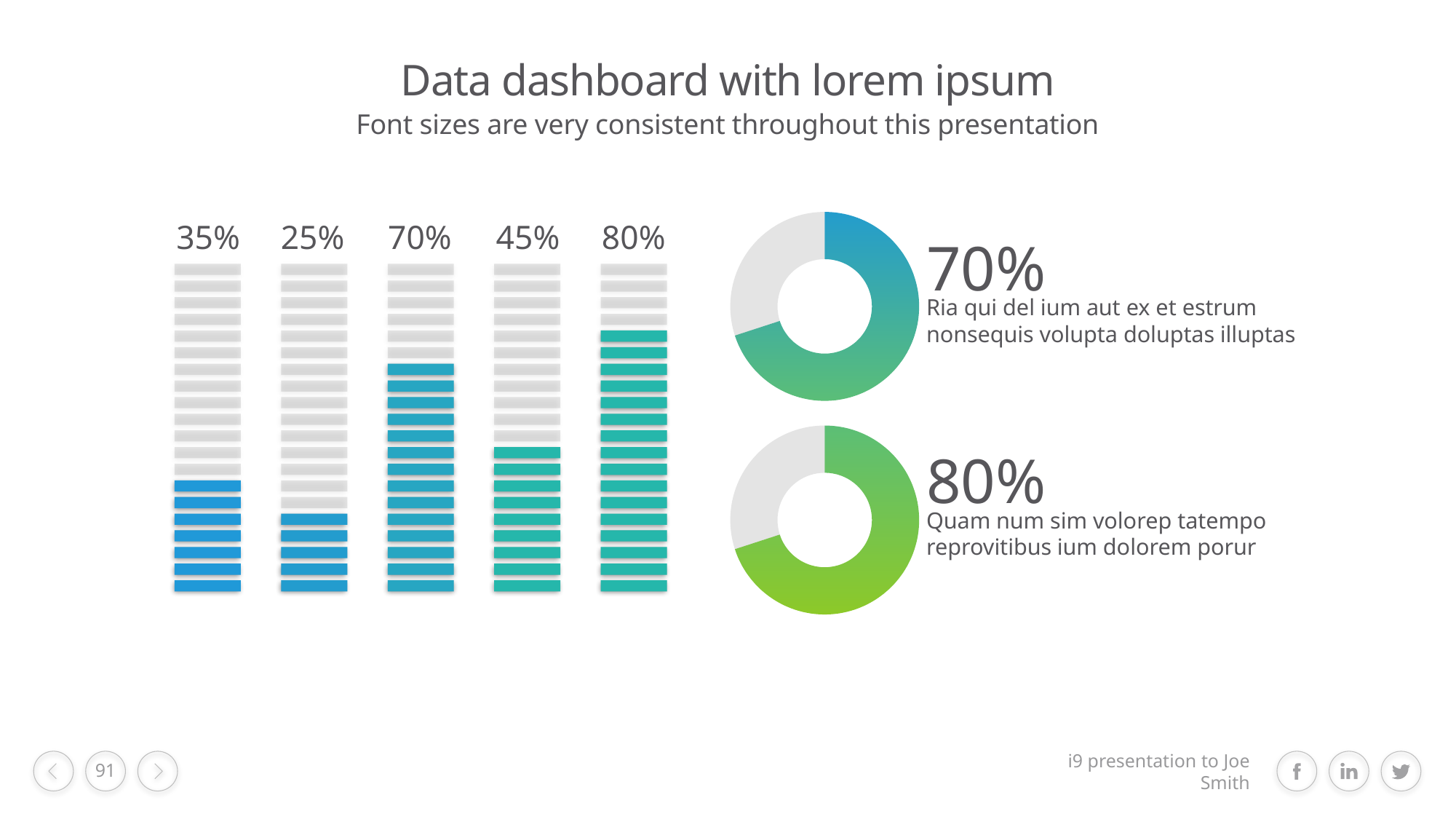
In the bar chart on the left, what value is shown above the third bar? 70% What percentage is shown next to the upper donut chart on the right? 70% In the bar chart on the left, which is larger: the first bar or the fourth bar? The fourth bar (45%) In the bar chart on the left, which bar has the lowest value? The second bar, 25% How many bars are in the bar chart on the left? 5 In the bar chart on the left, what is the difference between the third bar (70%) and the fourth bar (45%)? 25% In the bar chart on the left, what is the difference between the fifth bar (80%) and the second bar (25%)? 55% In the bar chart on the left, what value is shown above the first (leftmost) bar? 35% In the bar chart on the left, what value is shown above the fifth (rightmost) bar? 80% In the bar chart on the left, which bar has the highest value? The fifth (rightmost) bar, 80% What percentage is shown next to the lower donut chart on the right? 80% What type of chart is shown on the left side of the slide? Bar chart